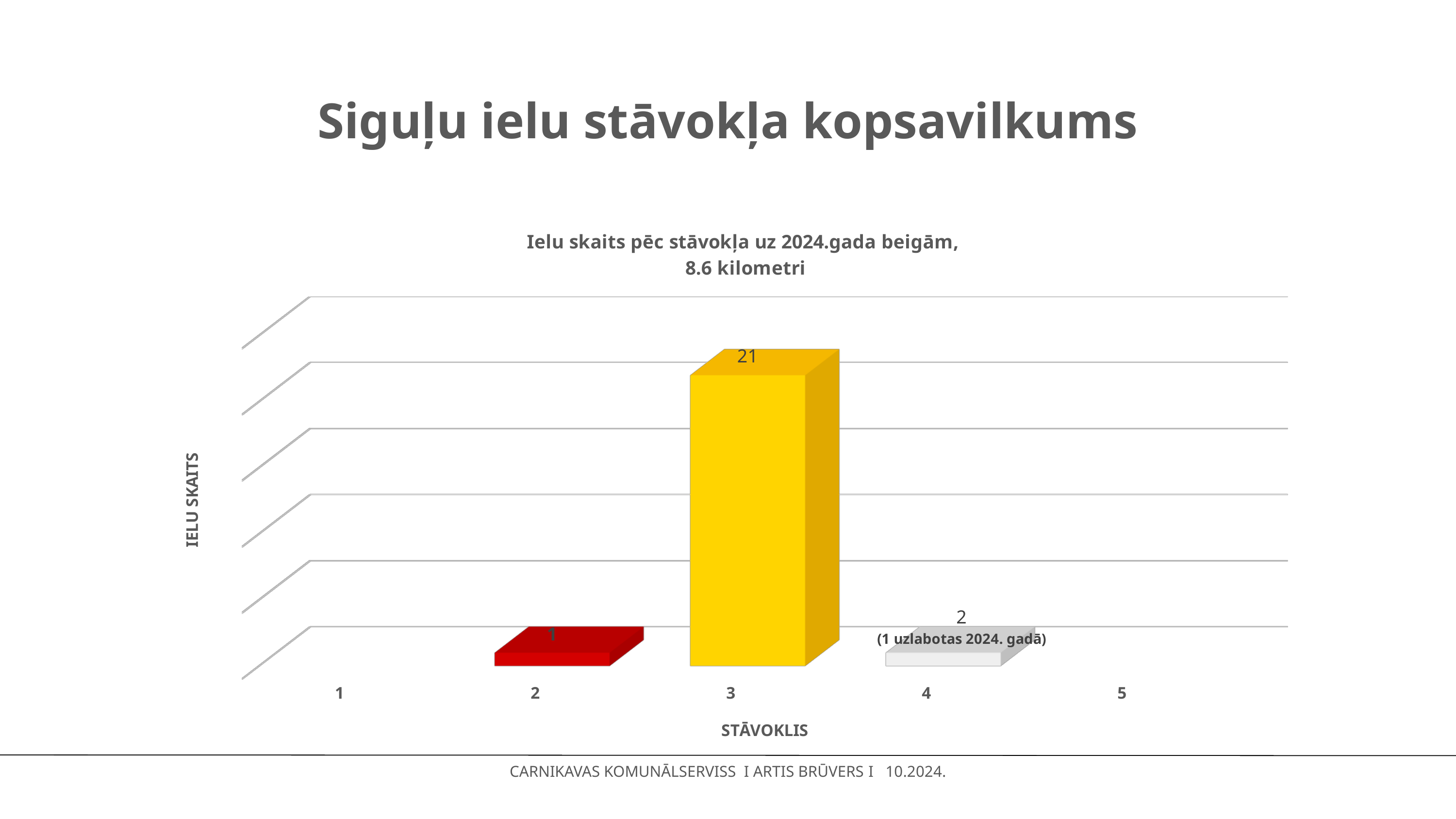
What is the value for condition (STĀVOKLIS) 4? 2 Which condition category has the highest number of streets? 3 What is the difference between the values for condition 3 and condition 4? 19 How many categories are shown on the x axis? 5 What is the title of the chart? Ielu skaits pēc stāvokļa uz 2024.gada beigām, 8.6 kilometri What is the label of the x axis? STĀVOKLIS What kind of chart is shown on the slide? bar chart What is the value for condition (STĀVOKLIS) 2? 1 Which is larger, the value for condition 2 or condition 4? condition 4 What is the total of the values for conditions 2, 3 and 4? 24 What is the value for condition (STĀVOKLIS) 3? 21 What is the difference between the values for condition 4 and condition 2? 1